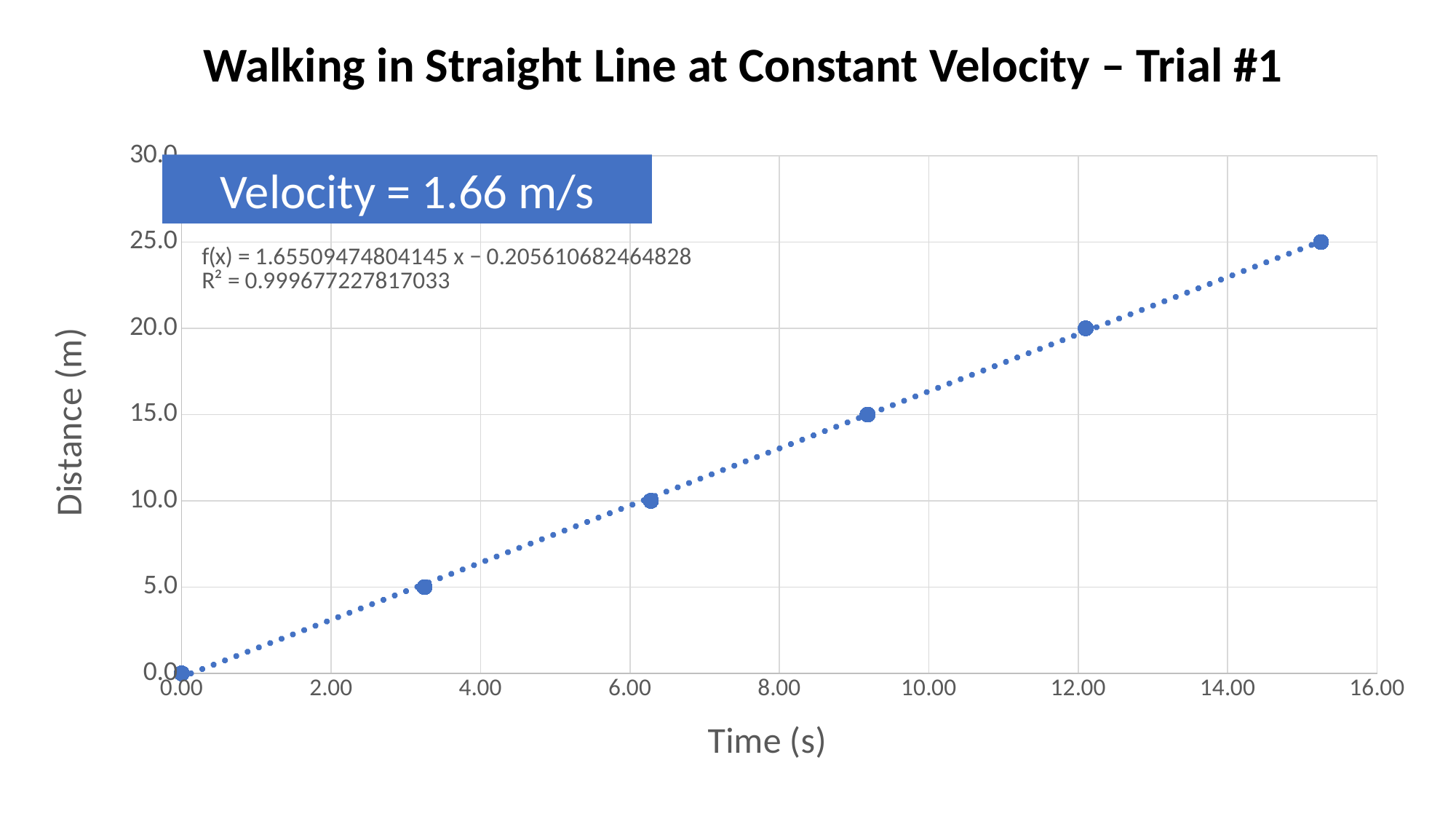
What is the highest distance value plotted on the chart? 25.0 Is the time of the data point at 15.0 m greater or less than 8.00 s? greater Is the time of the data point at 5.0 m greater or less than 4.00 s? less What velocity is stated in the box on the chart? 1.66 m/s What is the difference in distance between the highest and lowest plotted points? 25.0 Which is larger: the distance of the point near 12.00 s or the distance of the point near 6.00 s? the point near 12.00 s What is the title of the chart? Walking in Straight Line at Constant Velocity – Trial #1 What kind of chart is shown on the slide? scatter chart Is the time of the data point at 25.0 m greater or less than 14.00 s? greater Do the distance values rise or fall as time increases along the x axis? rise How many data points are plotted on the chart? 6 What is the lowest distance value plotted on the chart? 0.0